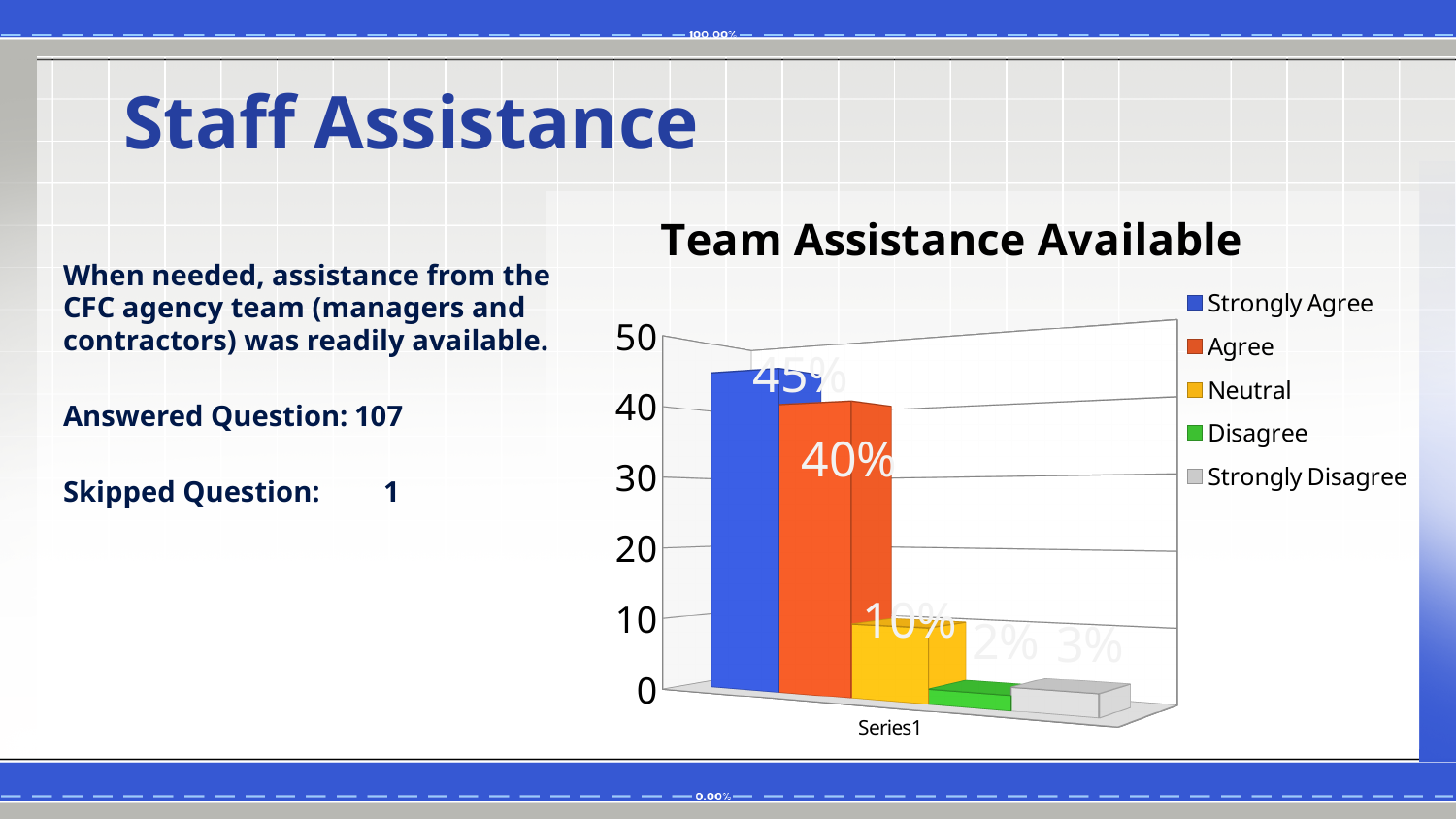
Which is larger in the Team Assistance Available chart, Neutral or Strongly Disagree? Neutral How many series does the legend of the Team Assistance Available chart list? 5 Which response category has the lowest value in the Team Assistance Available chart? Disagree What is the value for Neutral in the Team Assistance Available chart? 10% What is the difference between the Strongly Agree and Agree values in the Team Assistance Available chart? 5% What colour represents Neutral in the Team Assistance Available chart? Yellow What is the value for Agree in the Team Assistance Available chart? 40% What kind of chart is the Team Assistance Available chart? Bar chart Which response category has the highest value in the Team Assistance Available chart? Strongly Agree Is the value for Agree in the Team Assistance Available chart greater or less than 30? greater What is the value for Strongly Disagree in the Team Assistance Available chart? 3% What is the value for Strongly Agree in the Team Assistance Available chart? 45%